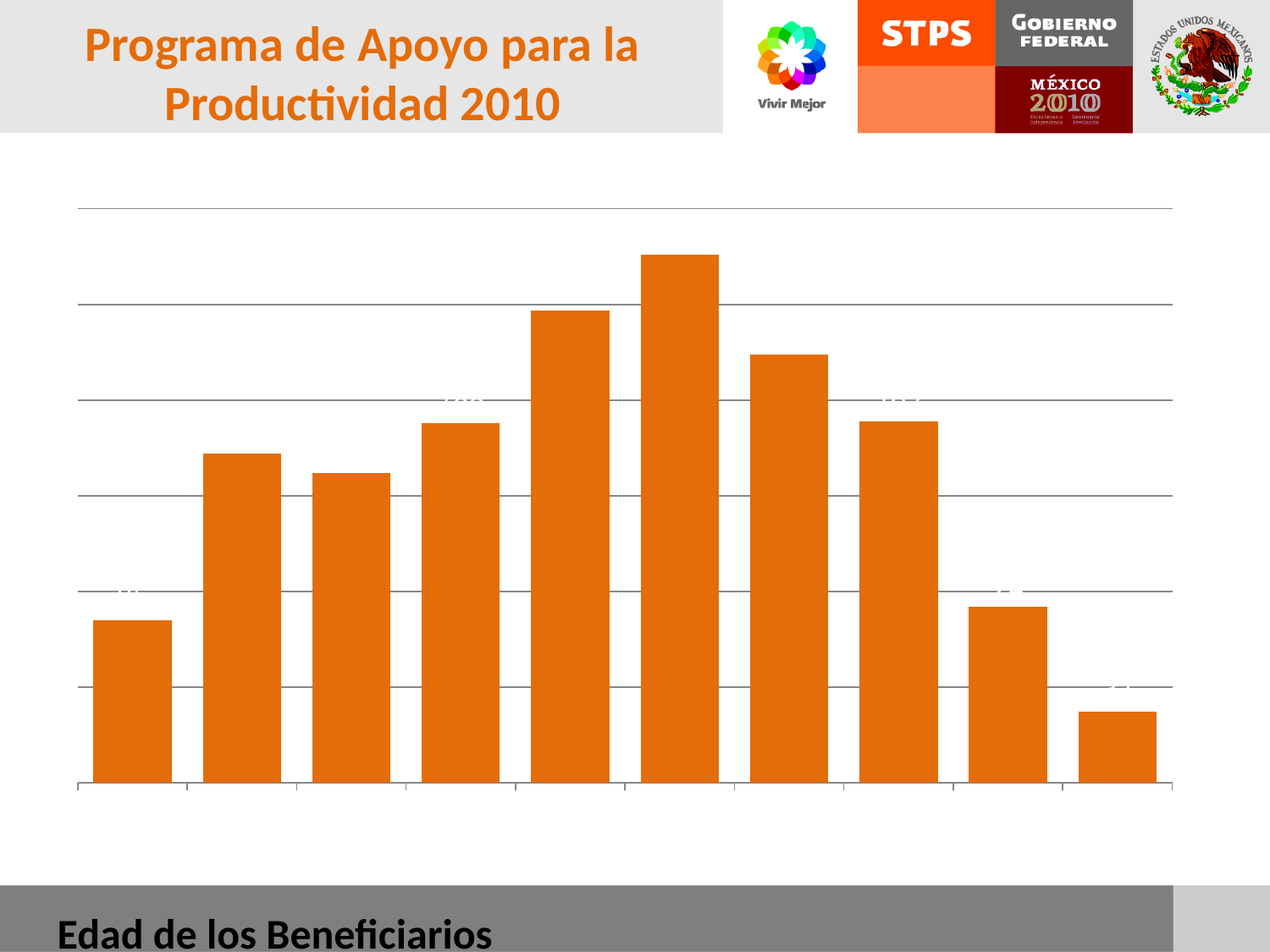
Which is taller, the fifth bar from the left or the seventh bar from the left? the fifth bar Which is taller, the first bar from the left or the last bar on the right? the first bar What caption appears in the band at the bottom of the slide below the chart? Edad de los Beneficiarios What kind of chart is shown on the slide? bar chart Do the bar heights rise steadily, fall steadily, or rise and then fall from left to right? rise and then fall What colour are the bars in the chart? orange How many bars are plotted in the chart? 10 Which is taller, the second bar from the left or the third bar from the left? the second bar Which bar is the shortest in the chart, counting from the left? the tenth (last) bar Which bar is the tallest in the chart, counting from the left? the sixth bar